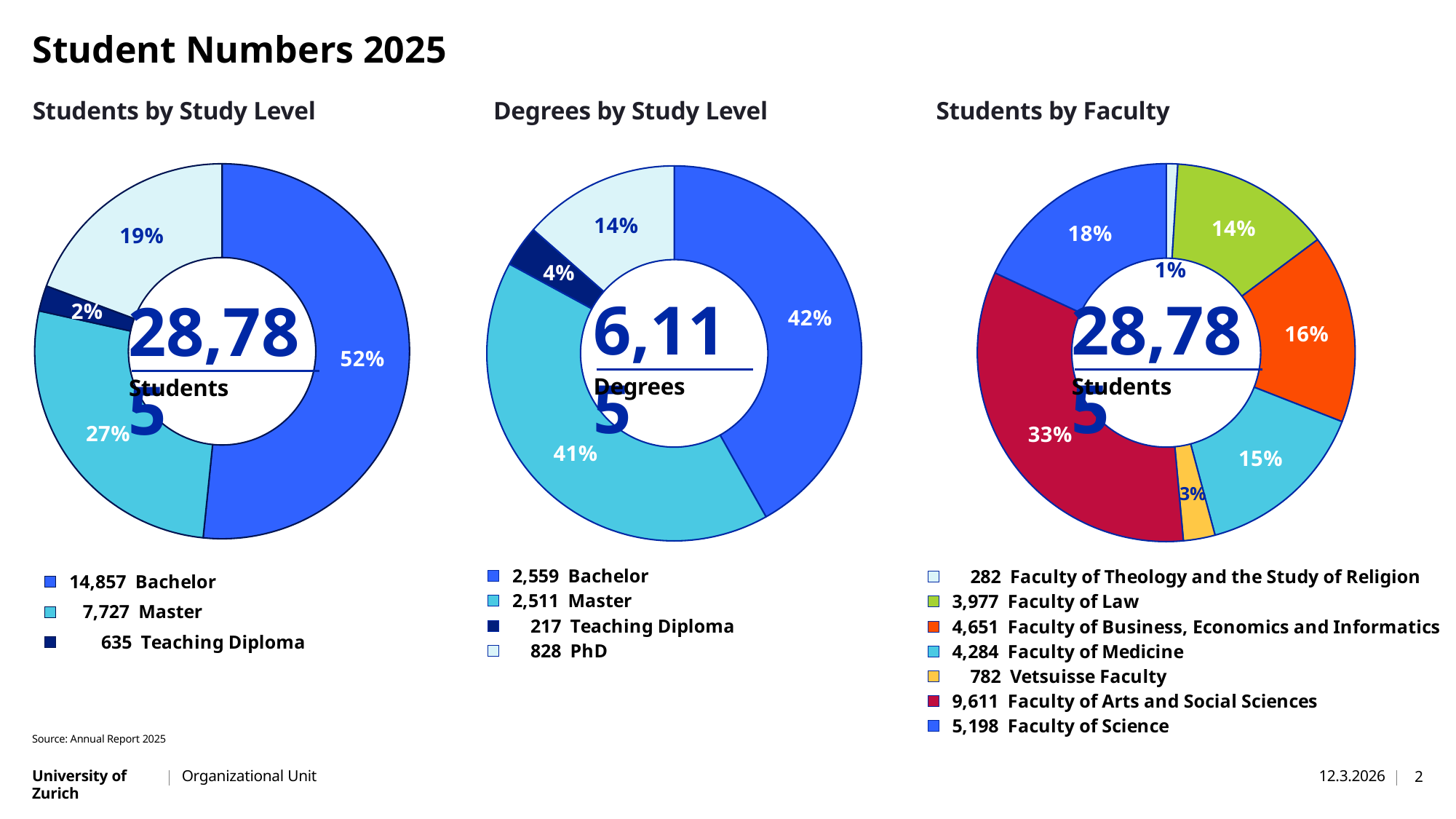
In the Students by Faculty chart, which faculty has the fewest students? Faculty of Theology and the Study of Religion In the Degrees by Study Level chart, what share of degrees are Teaching Diplomas? 4% In the Students by Faculty chart, how many students are in the Faculty of Medicine? 4,284 In the Degrees by Study Level chart, how many PhD degrees are shown? 828 In the Degrees by Study Level chart, which study level has the highest number of degrees? Bachelor In the Degrees by Study Level chart, what is the difference between the number of Bachelor degrees and Master degrees? 48 In the Students by Study Level chart, what share of students are at Master level? 27% In the Students by Study Level chart, how many students are at Bachelor level? 14,857 In the Students by Faculty chart, which faculty has the most students? Faculty of Arts and Social Sciences How many entries does the legend of the Students by Study Level chart list? 3 In the Students by Faculty chart, how many faculties are listed in the legend? 7 What kind of chart is the Students by Faculty chart? Doughnut chart